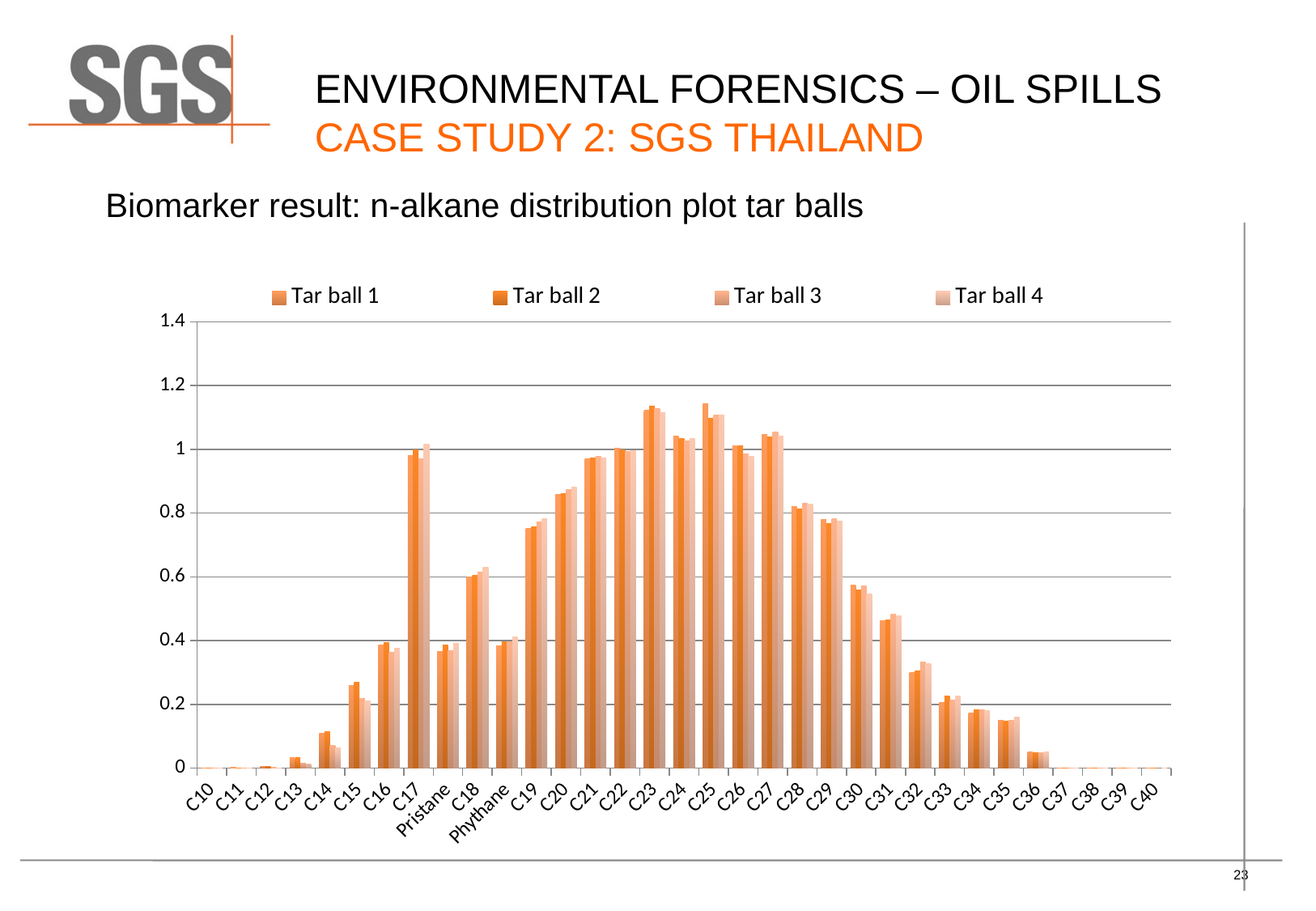
Is the value for Tar ball 1 at C20 greater or less than 0.8? greater Which is larger for Tar ball 1: the value at C17 or the value at C18? C17 How many series does the legend list? 4 Which is larger for Tar ball 1: the value at C29 or the value at C33? C29 How many categories are shown along the x axis? 33 Is the value for Tar ball 1 at C17 greater or less than 0.8? greater Is the value for Tar ball 1 at C36 greater or less than 0.2? less What kind of chart is shown on the slide? bar chart What are the names of the series in the legend? Tar ball 1, Tar ball 2, Tar ball 3, Tar ball 4 Do the values for Tar ball 1 rise or fall from C25 to C36? fall